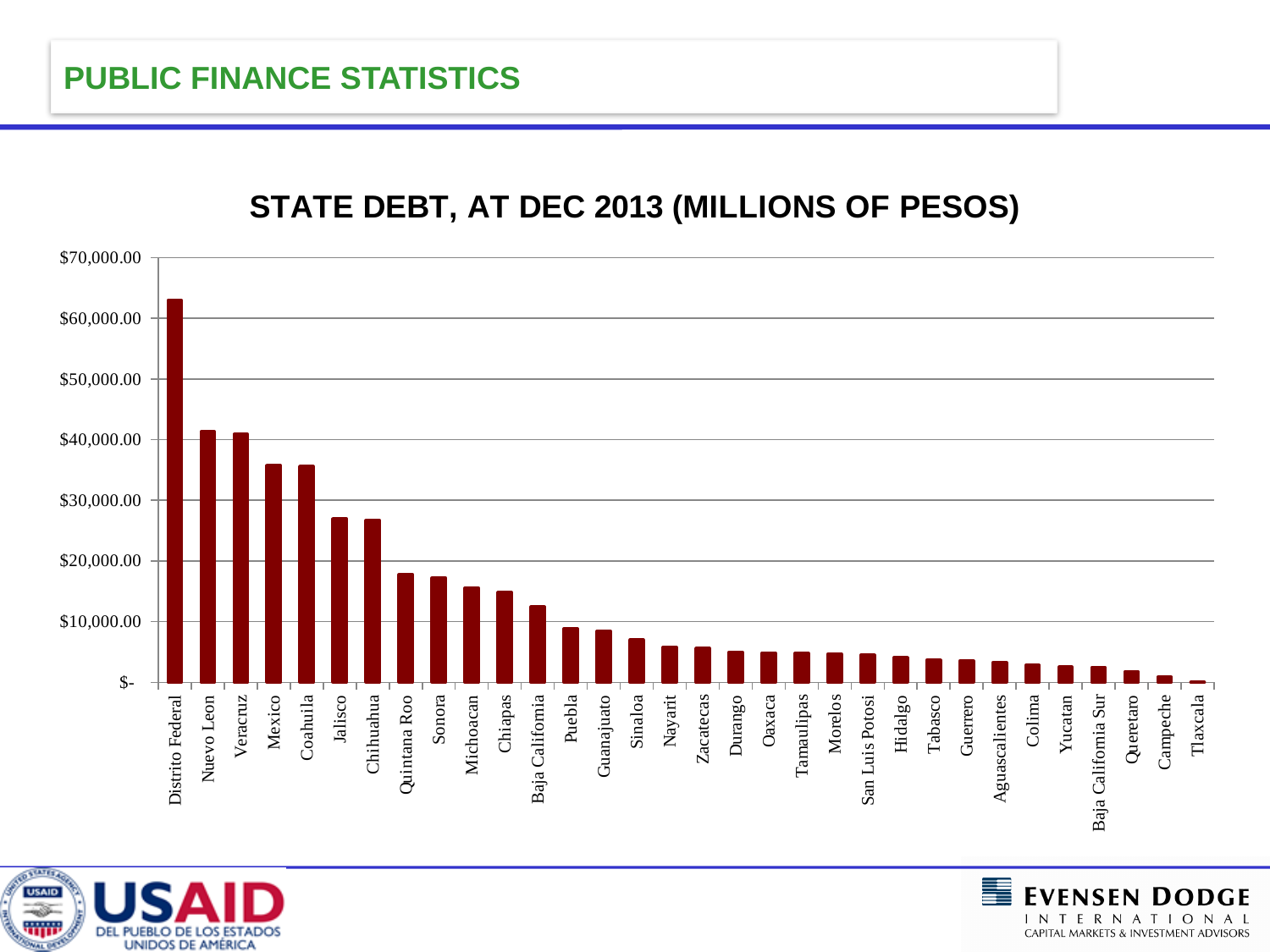
Is the value for Quintana Roo greater or less than $20,000.00? less Which state has the highest debt in the chart? Distrito Federal Is the value for Distrito Federal greater or less than $60,000.00? greater Do the values rise or fall moving from left to right along the x axis? Fall Is the value for Chiapas greater or less than $10,000.00? greater What is the title of the chart? STATE DEBT, AT DEC 2013 (MILLIONS OF PESOS) Which has a larger value, Jalisco or Quintana Roo? Jalisco What type of chart is shown on the slide? Bar chart How many states are shown on the x axis of the chart? 32 Which state has the lowest debt in the chart? Tlaxcala